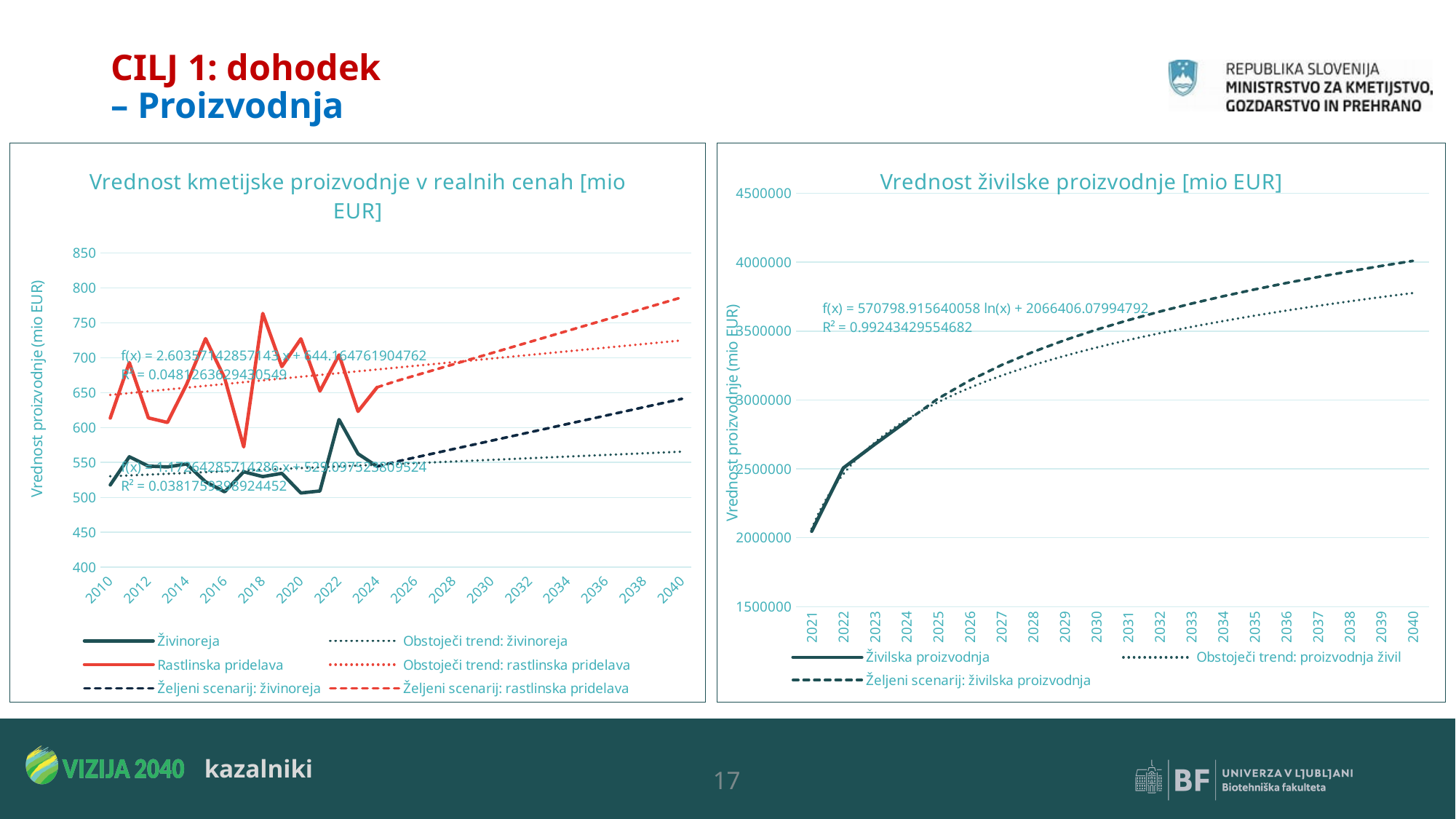
How many series does the legend of the left chart, 'Vrednost kmetijske proizvodnje v realnih cenah [mio EUR]', list? 6 What is the y-axis title of the right chart, 'Vrednost živilske proizvodnje [mio EUR]'? Vrednost proizvodnje (mio EUR) What kind of chart is the right chart, 'Vrednost živilske proizvodnje [mio EUR]'? line chart In the right chart, 'Vrednost živilske proizvodnje [mio EUR]', is the value of Obstoječi trend: proizvodnja živil in 2040 greater or less than 4000000? less In the left chart, 'Vrednost kmetijske proizvodnje v realnih cenah [mio EUR]', is the value of Živinoreja in 2016 greater or less than 550? less In the left chart, 'Vrednost kmetijske proizvodnje v realnih cenah [mio EUR]', is the value of Rastlinska pridelava in 2018 greater or less than 750? greater How many series does the legend of the right chart, 'Vrednost živilske proizvodnje [mio EUR]', list? 3 What kind of chart is the left chart, 'Vrednost kmetijske proizvodnje v realnih cenah [mio EUR]'? line chart In the left chart, 'Vrednost kmetijske proizvodnje v realnih cenah [mio EUR]', which series has higher values throughout, Živinoreja or Rastlinska pridelava? Rastlinska pridelava In the right chart, 'Vrednost živilske proizvodnje [mio EUR]', which series is higher in 2040, Željeni scenarij: živilska proizvodnja or Obstoječi trend: proizvodnja živil? Željeni scenarij: živilska proizvodnja In the right chart, 'Vrednost živilske proizvodnje [mio EUR]', does the Živilska proizvodnja line rise or fall from 2021 to 2024? rise